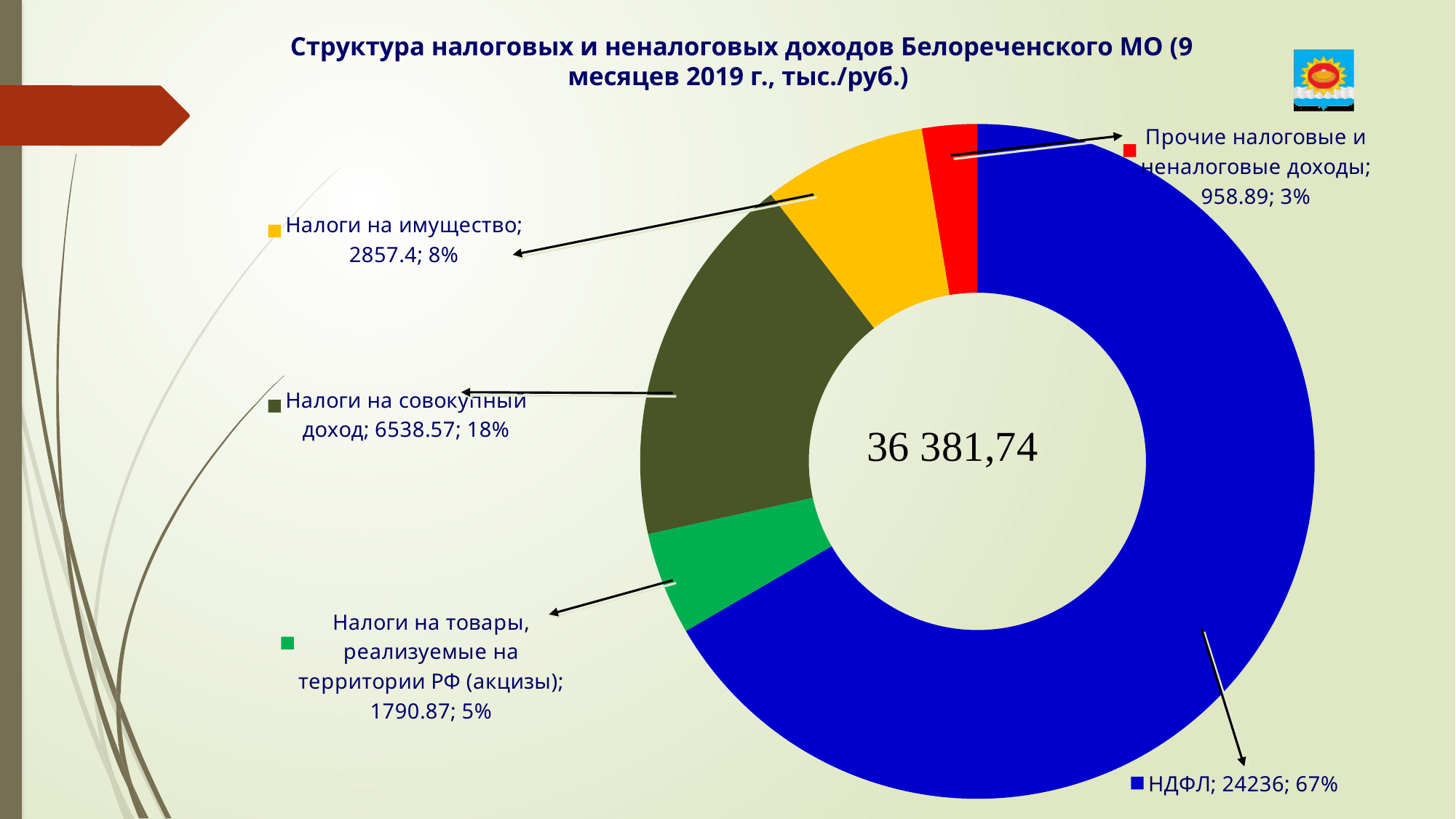
What share of the chart does НДФЛ represent? 67% Which is larger: Налоги на имущество or Налоги на товары, реализуемые на территории РФ (акцизы)? Налоги на имущество Which category has the lowest value? Прочие налоговые и неналоговые доходы What is the value for Прочие налоговые и неналоговые доходы? 958.89 Which category has the highest value? НДФЛ What is the value for Налоги на имущество? 2857.4 What share of the chart does Налоги на товары, реализуемые на территории РФ (акцизы) represent? 5% What is the value for Налоги на совокупный доход? 6538.57 What is the difference between the values for Налоги на совокупный доход and Налоги на имущество? 3681.17 What is the value for НДФЛ? 24236 What type of chart is shown on the slide? Doughnut chart How many categories are shown in the chart? 5